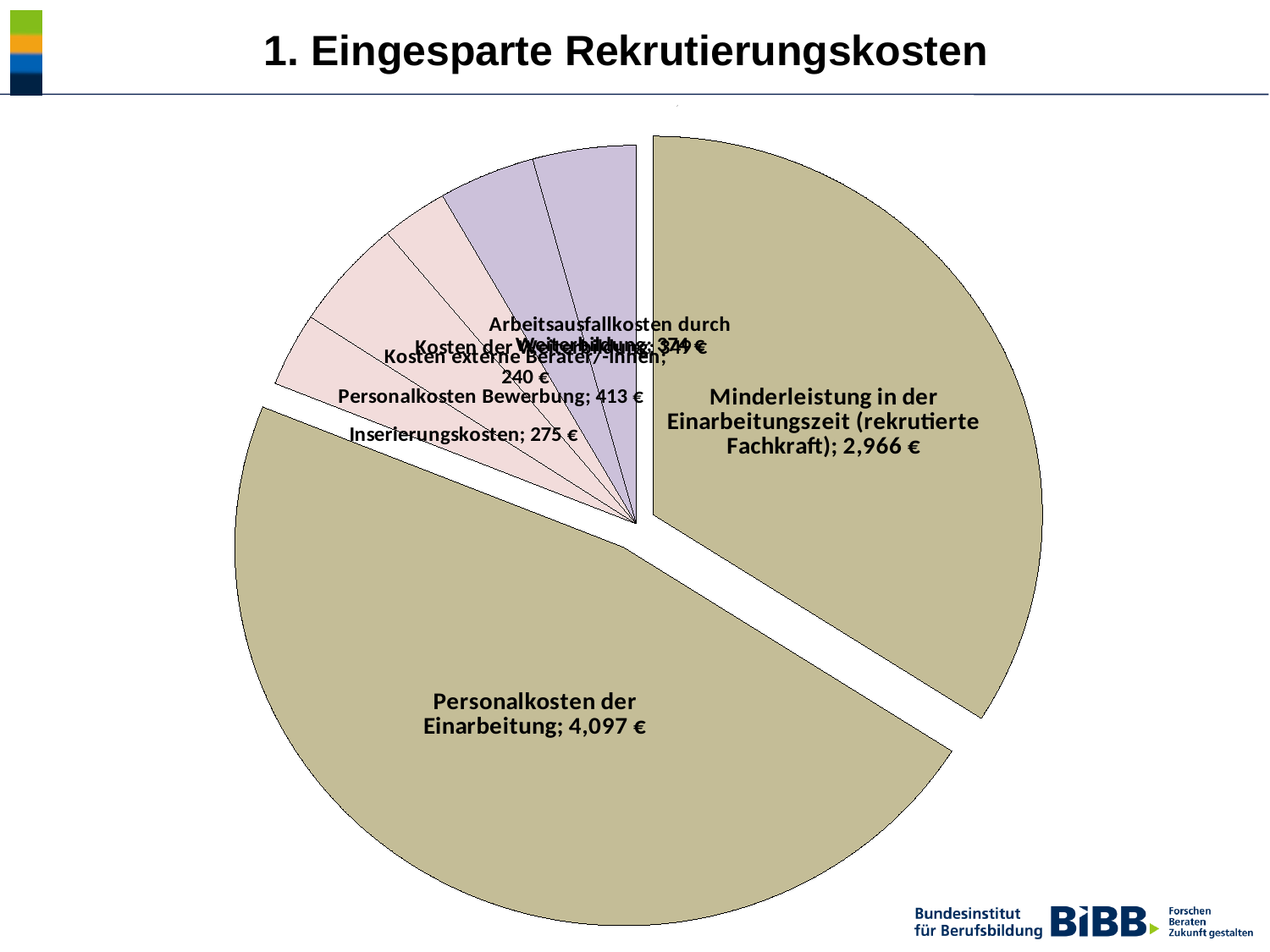
Which category has the largest slice of the pie? Personalkosten der Einarbeitung What is the difference between Personalkosten Bewerbung and Inserierungskosten? 138 € What is the value shown for Inserierungskosten? 275 € What is the value shown for Personalkosten Bewerbung? 413 € What is the difference between Personalkosten der Einarbeitung and Minderleistung in der Einarbeitungszeit? 1,131 € What is the value shown for Kosten externe Berater/-innen? 240 € What is the value shown for Personalkosten der Einarbeitung? 4,097 € Which is larger: Personalkosten der Einarbeitung or Minderleistung in der Einarbeitungszeit? Personalkosten der Einarbeitung What is the value shown for Minderleistung in der Einarbeitungszeit (rekrutierte Fachkraft)? 2,966 € Which is larger: Inserierungskosten or Personalkosten Bewerbung? Personalkosten Bewerbung What is the title of the slide? 1. Eingesparte Rekrutierungskosten What kind of chart is shown on the slide? Pie chart